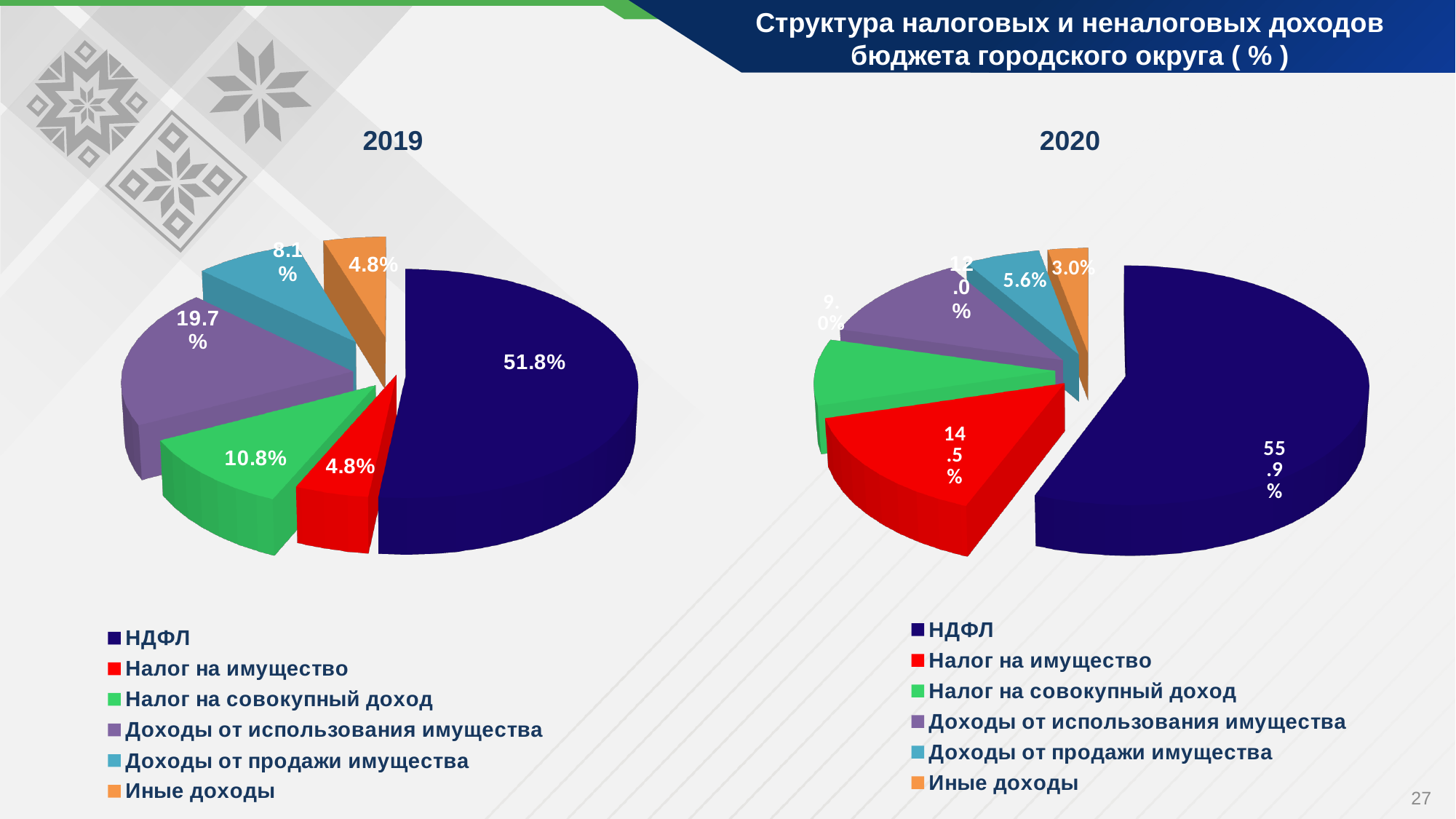
What is the difference between the НДФЛ share in 2020 and in 2019? 4.1 percentage points In the 2019 pie chart, what share does НДФЛ have? 51.8% In the 2019 pie chart, which is larger: Налог на совокупный доход or Доходы от продажи имущества? Налог на совокупный доход In the 2020 pie chart, what share does НДФЛ have? 55.9% In the 2020 pie chart, what is the value for Налог на имущество? 14.5% How many categories does the legend of the 2020 pie chart list? 6 In the 2019 pie chart, which category has the largest share? НДФЛ In the 2019 pie chart, which colour represents Иные доходы? Orange What type of chart is used for the 2019 data? Pie chart In the 2020 pie chart, which category has the smallest share? Иные доходы In the 2019 pie chart, what is the value for Доходы от использования имущества? 19.7% In the 2020 pie chart, what is the value for Доходы от продажи имущества? 5.6%